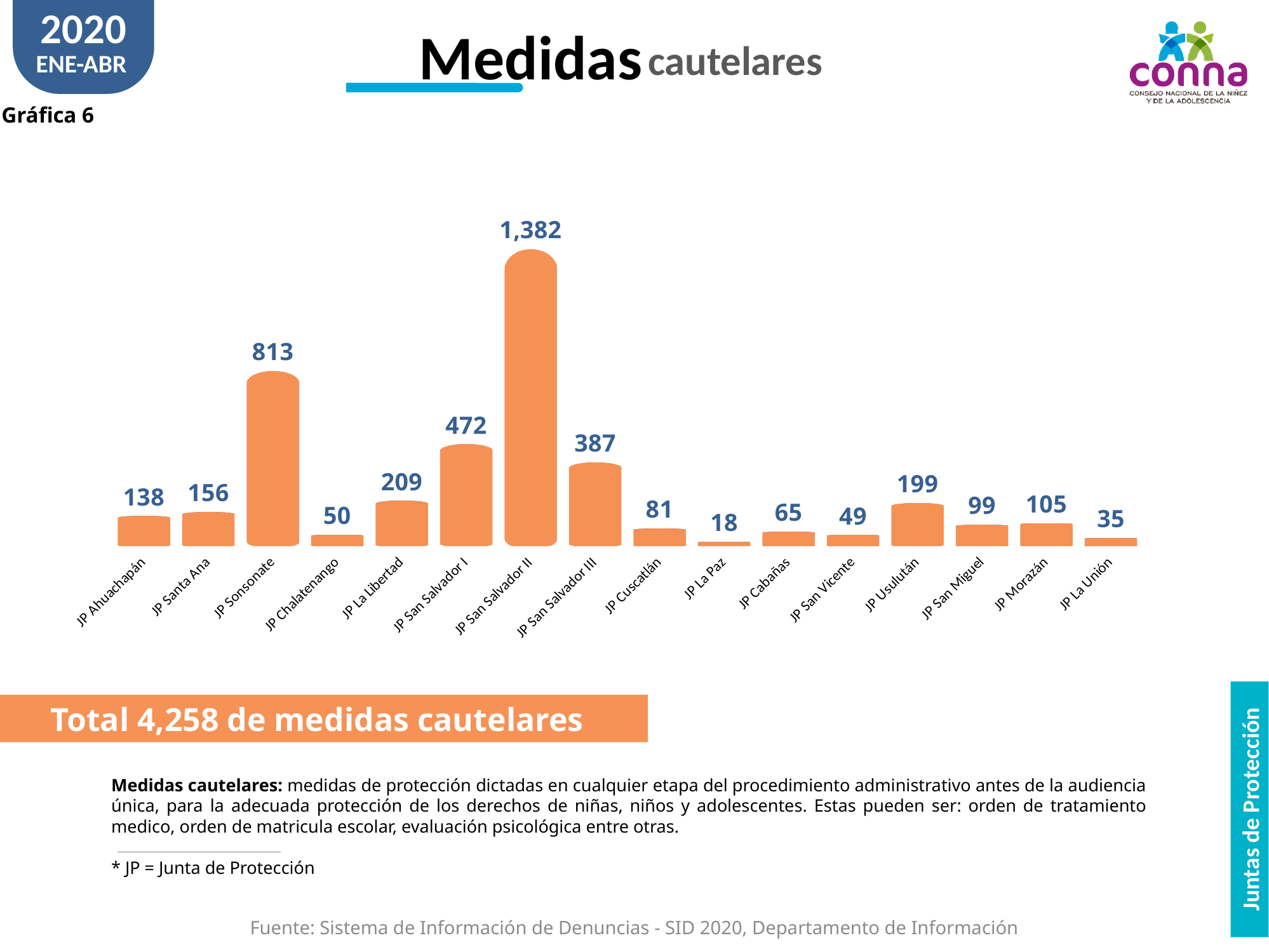
Which is larger, the value for JP Santa Ana or the value for JP Ahuachapán? JP Santa Ana What is the value for JP San Salvador II? 1,382 How many categories are shown on the x axis? 16 What is the value for JP Usulután? 199 Which category has the lowest value? JP La Paz What total of medidas cautelares is stated on the slide? 4,258 What kind of chart is shown on the slide? Bar chart What is the value for JP Sonsonate? 813 What is the value for JP La Paz? 18 What is the difference between the values for JP San Salvador I and JP San Salvador III? 85 Which category has the highest value? JP San Salvador II What is the difference between the values for JP Morazán and JP La Unión? 70